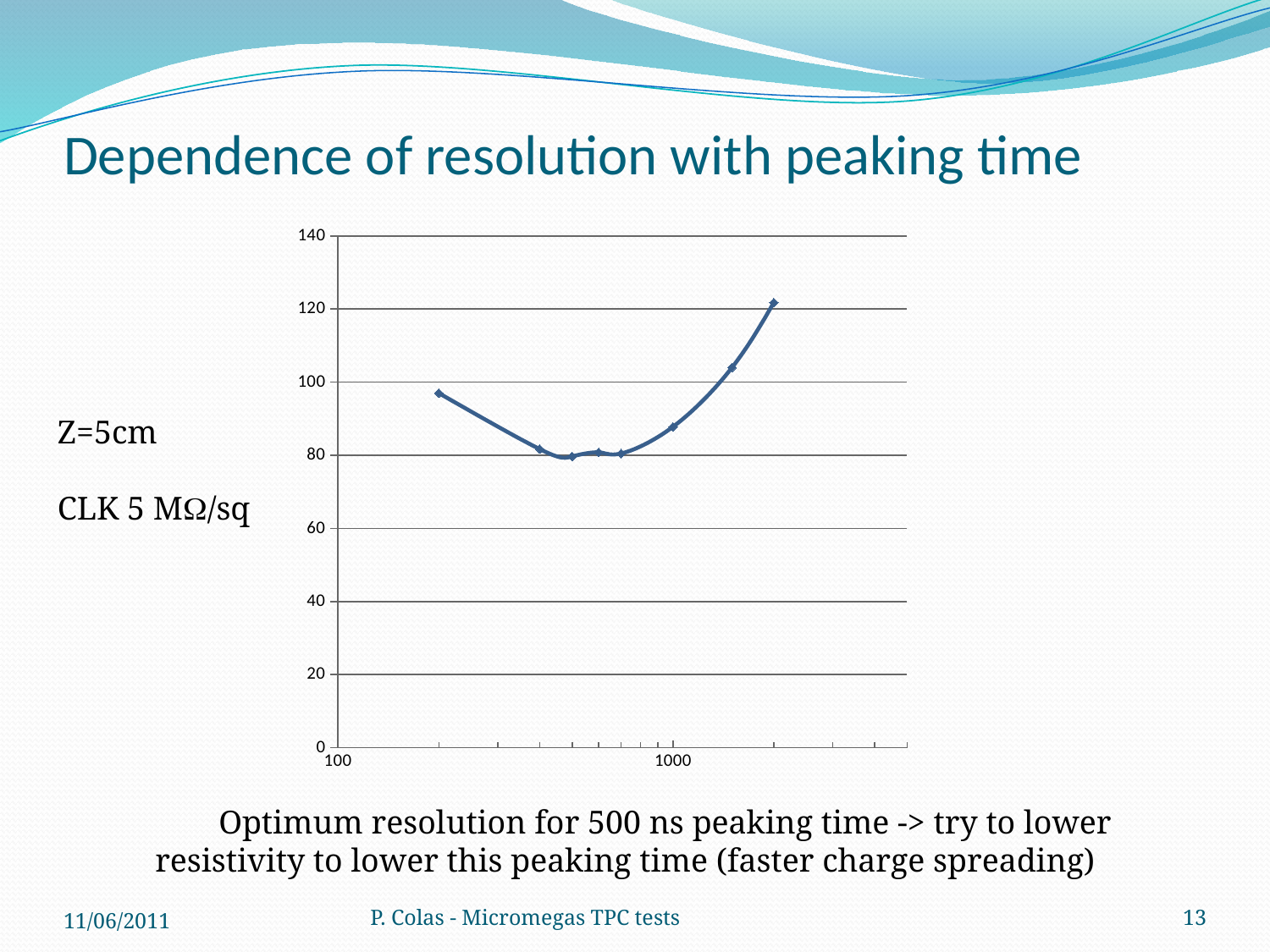
How many data points are plotted on the line? 8 Is the lowest point on the curve greater or less than 100? less What kind of chart is shown on the slide? line chart Which data point has the highest value, the leftmost or the rightmost? the rightmost What is the maximum value shown on the y axis? 140 Is the highest point on the curve greater or less than 100? greater Is the value of the leftmost data point greater or less than 80? greater How do the values change moving from left to right along the x axis? they fall, then rise What is the title of the chart? Dependence of resolution with peaking time